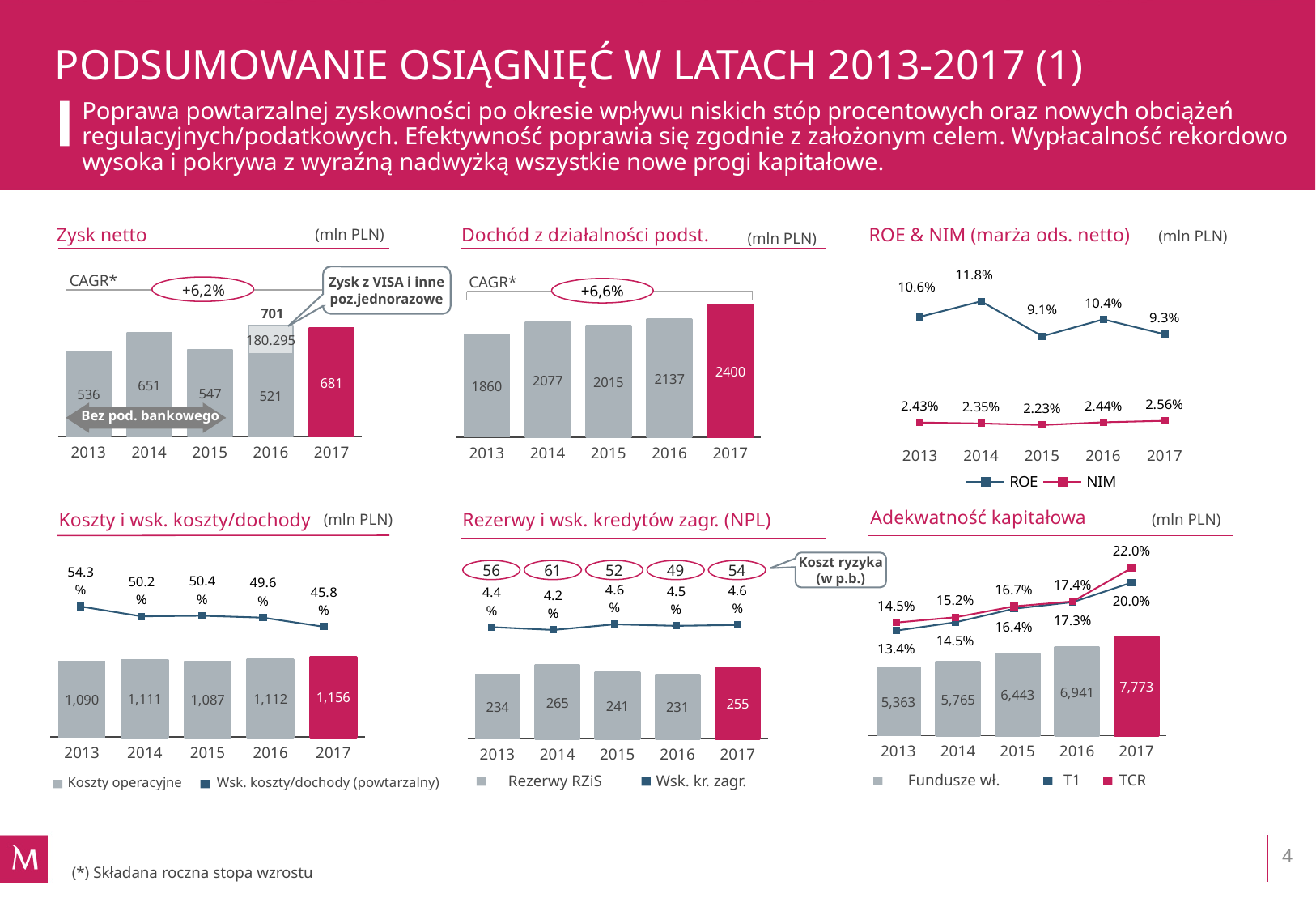
In the 'Zysk netto' chart, what is the difference between the 2017 value and the 2016 value of 521? 160 In the 'Dochód z działalności podst.' chart, which year has the lowest value? 2013 In the 'Koszty i wsk. koszty/dochody' chart, what is the Koszty operacyjne value for 2017? 1,156 In the 'Adekwatność kapitałowa' chart, how many years are shown on the x axis? 5 In the 'Adekwatność kapitałowa' chart, what is the TCR value for 2017? 22.0% In the 'ROE & NIM' chart, which year has the highest NIM value? 2017 In the 'Zysk netto' chart, what is the value for 2014? 651 In the 'ROE & NIM' chart, how many series does the legend list? 2 In the 'ROE & NIM' chart, what is the ROE value for 2014? 11.8% In the 'Koszty i wsk. koszty/dochody' chart, does the Wsk. koszty/dochody line rise or fall from 2013 to 2017? fall In the 'Rezerwy i wsk. kredytów zagr. (NPL)' chart, which year has the highest Rezerwy RZiS value? 2014 In the 'Dochód z działalności podst.' chart, what is the value for 2017? 2400